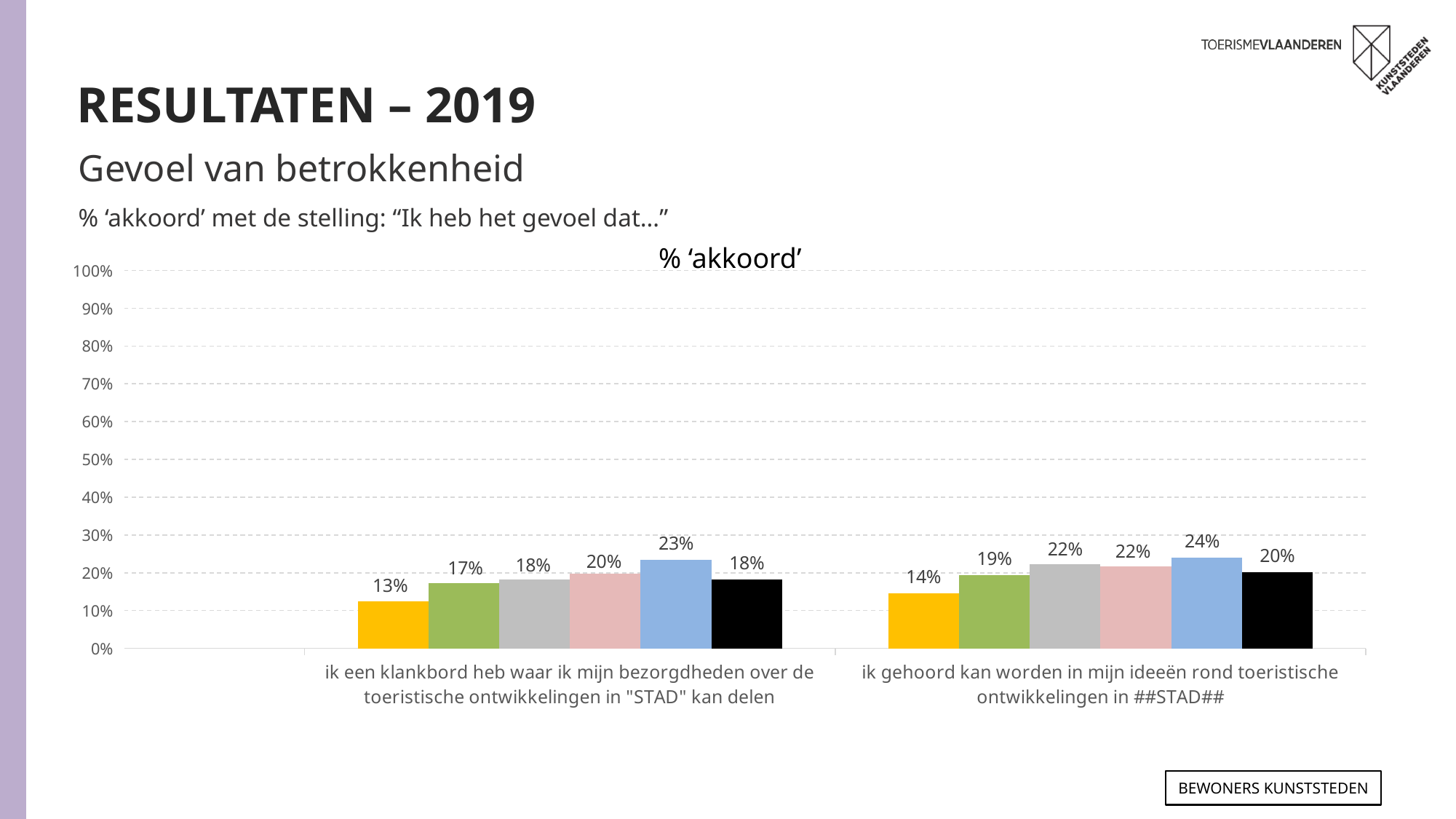
How many categories are shown on the x axis of the chart? 2 Is the value of the blue bar for "ik gehoord kan worden in mijn ideeën rond toeristische ontwikkelingen in ##STAD##" greater or less than 30%? less What is the value of the black bar for the category "ik een klankbord heb waar ik mijn bezorgdheden over de toeristische ontwikkelingen in "STAD" kan delen"? 18% What is the value of the green bar for the category "ik gehoord kan worden in mijn ideeën rond toeristische ontwikkelingen in ##STAD##"? 19% Which is larger: the pink bar for "ik een klankbord heb..." or the pink bar for "ik gehoord kan worden..."? ik gehoord kan worden... Which colour bar has the highest value in the category "ik een klankbord heb waar ik mijn bezorgdheden over de toeristische ontwikkelingen in "STAD" kan delen"? blue What is the difference between the blue bar and the yellow bar in the category "ik een klankbord heb waar ik mijn bezorgdheden over de toeristische ontwikkelingen in "STAD" kan delen"? 10% Which colour bar has the lowest value in the category "ik gehoord kan worden in mijn ideeën rond toeristische ontwikkelingen in ##STAD##"? yellow What is the title of the chart? % ‘akkoord’ What is the value of the yellow bar for the category "ik een klankbord heb waar ik mijn bezorgdheden over de toeristische ontwikkelingen in "STAD" kan delen"? 13% What is the value of the blue bar for the category "ik gehoord kan worden in mijn ideeën rond toeristische ontwikkelingen in ##STAD##"? 24% What type of chart is shown on the slide? bar chart